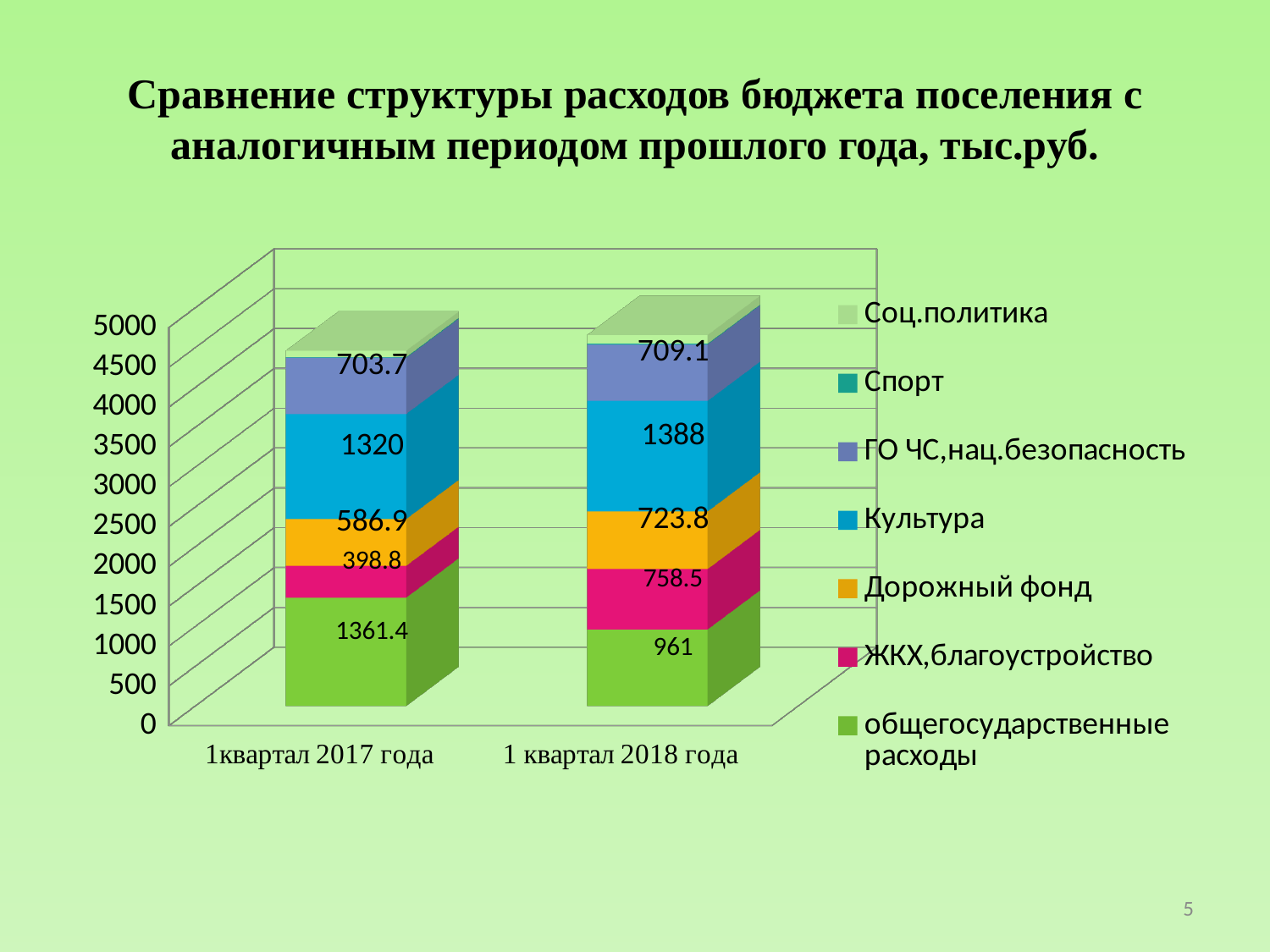
What is the value for Дорожный фонд in 1квартал 2017 года? 586.9 What kind of chart is shown on the slide? stacked bar chart What is the value for общегосударственные расходы in 1квартал 2017 года? 1361.4 What is the difference between Культура in 1 квартал 2018 года and in 1квартал 2017 года? 68 Which is larger: общегосударственные расходы in 1квартал 2017 года or in 1 квартал 2018 года? 1квартал 2017 года What is the difference between ЖКХ,благоустройство in 1 квартал 2018 года and in 1квартал 2017 года? 359.7 What is the value for Культура in 1 квартал 2018 года? 1388 What is the value for ЖКХ,благоустройство in 1 квартал 2018 года? 758.5 Which legend entry is shown in light green at the top of the legend? Соц.политика How many series does the legend list? 7 How many categories are shown on the x axis? 2 What is the value for ГО ЧС,нац.безопасность in 1 квартал 2018 года? 709.1